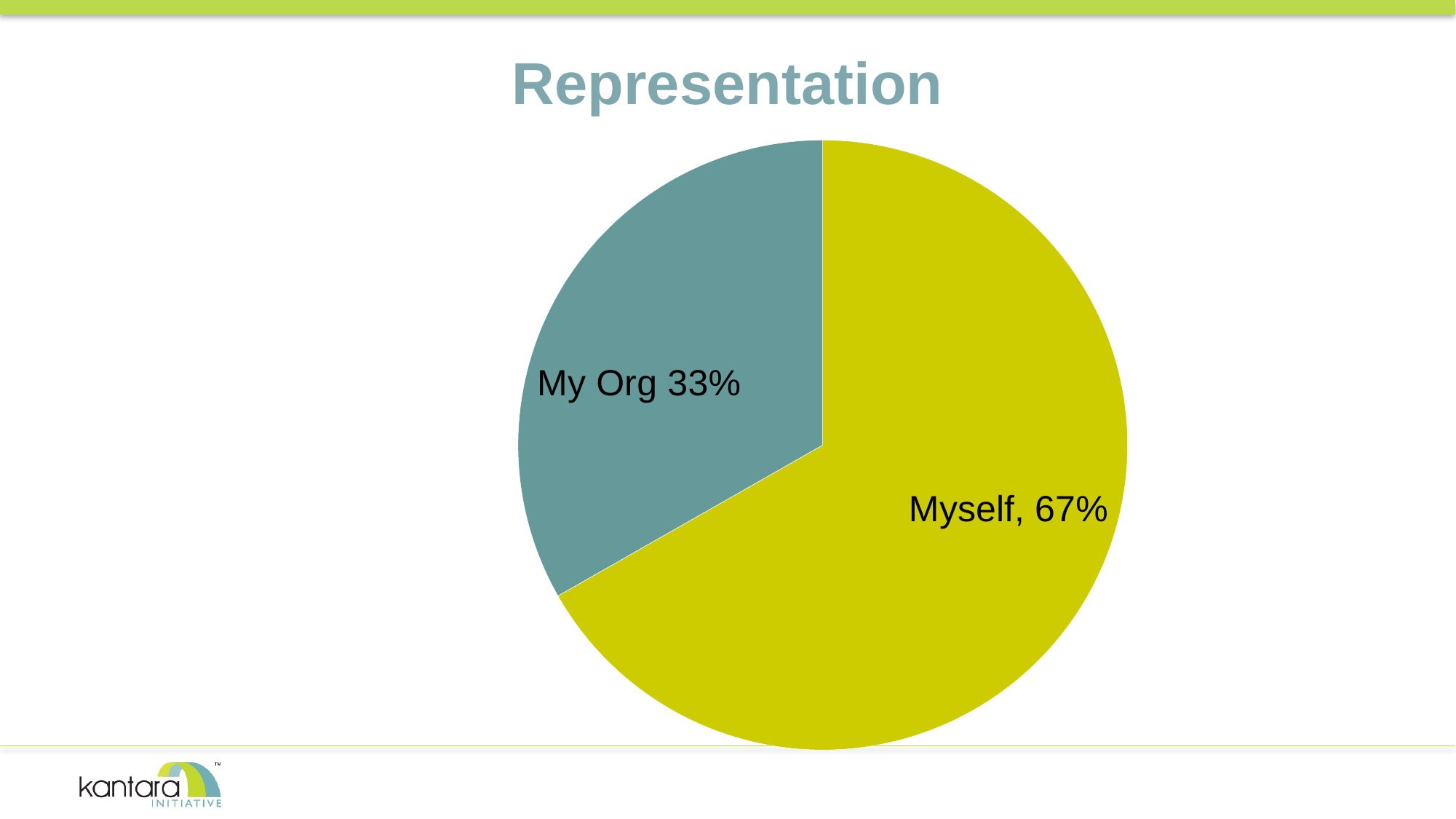
What is the difference in percentage points between the Myself slice and the My Org slice? 34 What share of the pie does the My Org slice represent? 33% What share of the pie does the Myself slice represent? 67% Is the value for My Org greater or less than 50%? less Which is larger, the Myself slice or the My Org slice? Myself How many slices does the pie chart have? 2 Which slice is the largest? Myself Which slice is the smallest? My Org What colour is the Myself slice? yellow-green What is the title of the chart? Representation What kind of chart is shown on the slide? pie chart